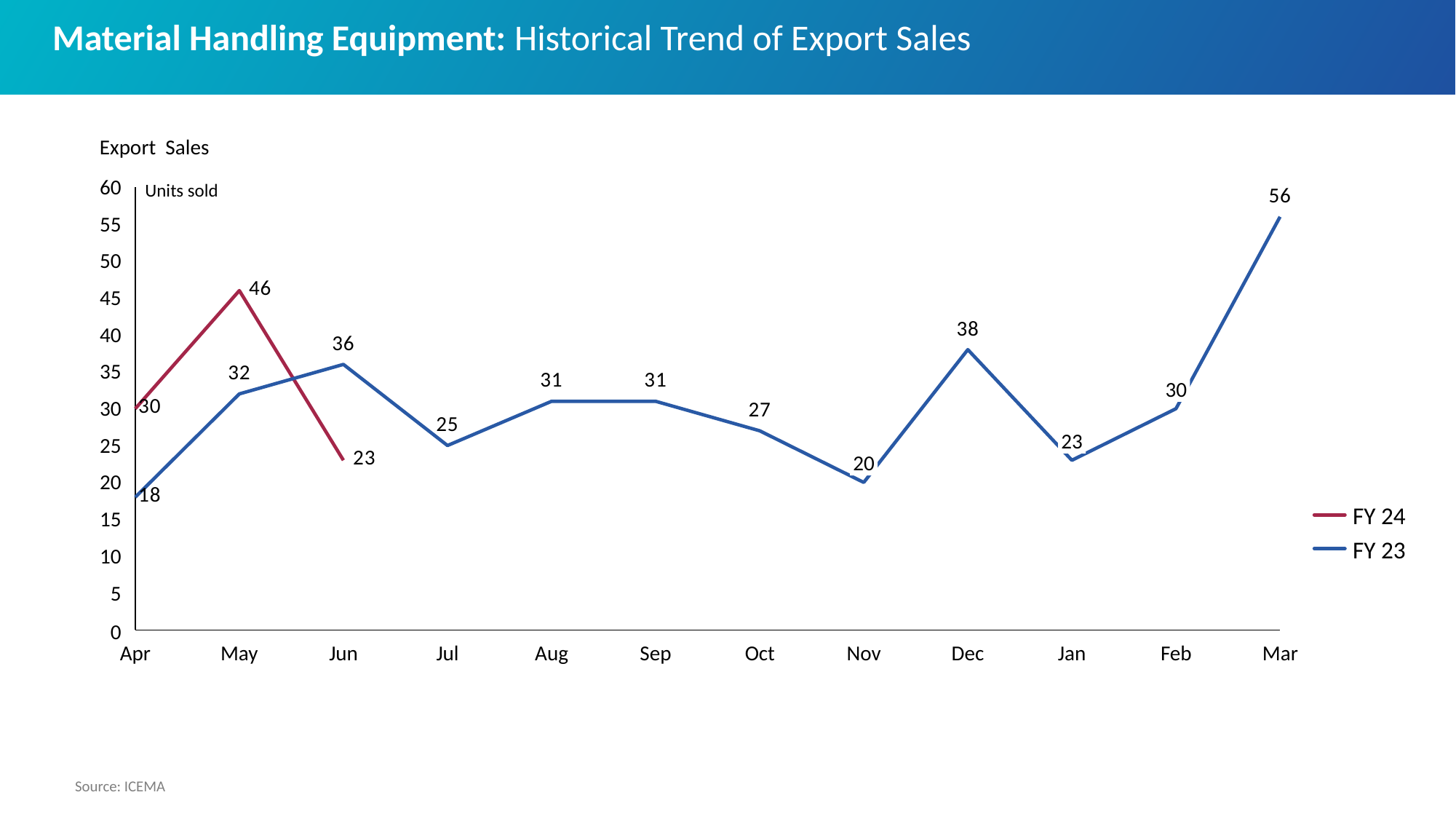
How many series does the legend list? 2 What is the FY 23 export sales value for Mar? 56 What is the FY 24 export sales value for May? 46 What is the difference between FY 24 and FY 23 export sales in May? 14 How many months are shown on the x axis? 12 Which month has the highest FY 23 export sales? Mar What is the FY 23 export sales value for Nov? 20 What unit is indicated on the y axis of the chart? Units sold Which is larger in Jun: FY 24 or FY 23 export sales? FY 23 What kind of chart is shown on the slide? Line chart Which month has the lowest FY 23 export sales? Apr Does the FY 24 line rise or fall from May to Jun? Fall